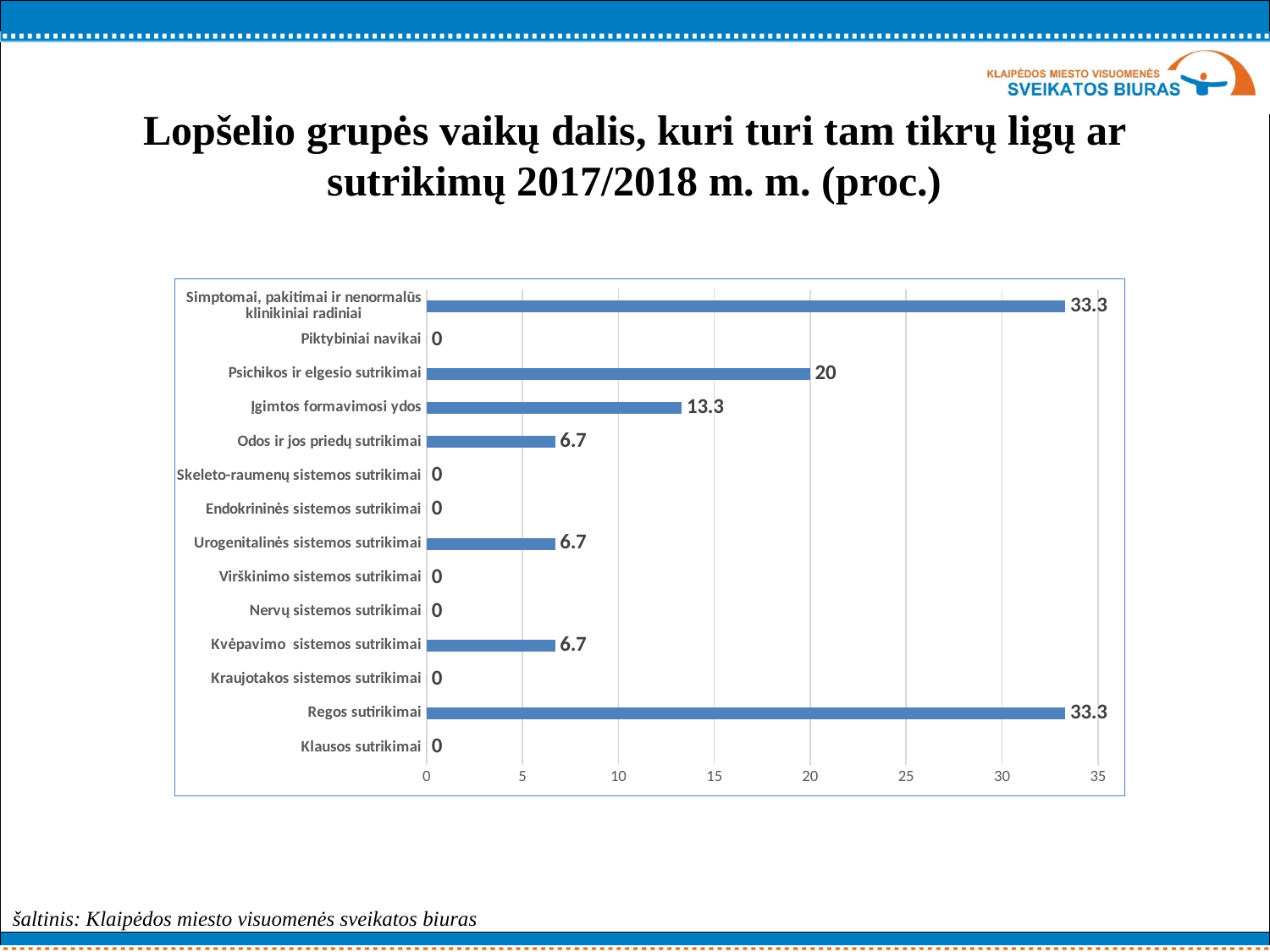
How many categories are shown on the chart? 14 What is the difference between the values for Regos sutirikimai and Odos ir jos priedų sutrikimai? 26.6 What is the value for Kvėpavimo sistemos sutrikimai? 6.7 What is the value for Psichikos ir elgesio sutrikimai? 20 Which is larger: the value for Psichikos ir elgesio sutrikimai or the value for Urogenitalinės sistemos sutrikimai? Psichikos ir elgesio sutrikimai What is the value for Įgimtos formavimosi ydos? 13.3 What is the highest value shown on the horizontal axis? 35 What is the value for Piktybiniai navikai? 0 What is the difference between the values for Psichikos ir elgesio sutrikimai and Įgimtos formavimosi ydos? 6.7 What is the value for Regos sutirikimai? 33.3 What kind of chart is shown on the slide? bar chart Is the value for Simptomai, pakitimai ir nenormalūs klinikiniai radiniai greater or less than 30? greater